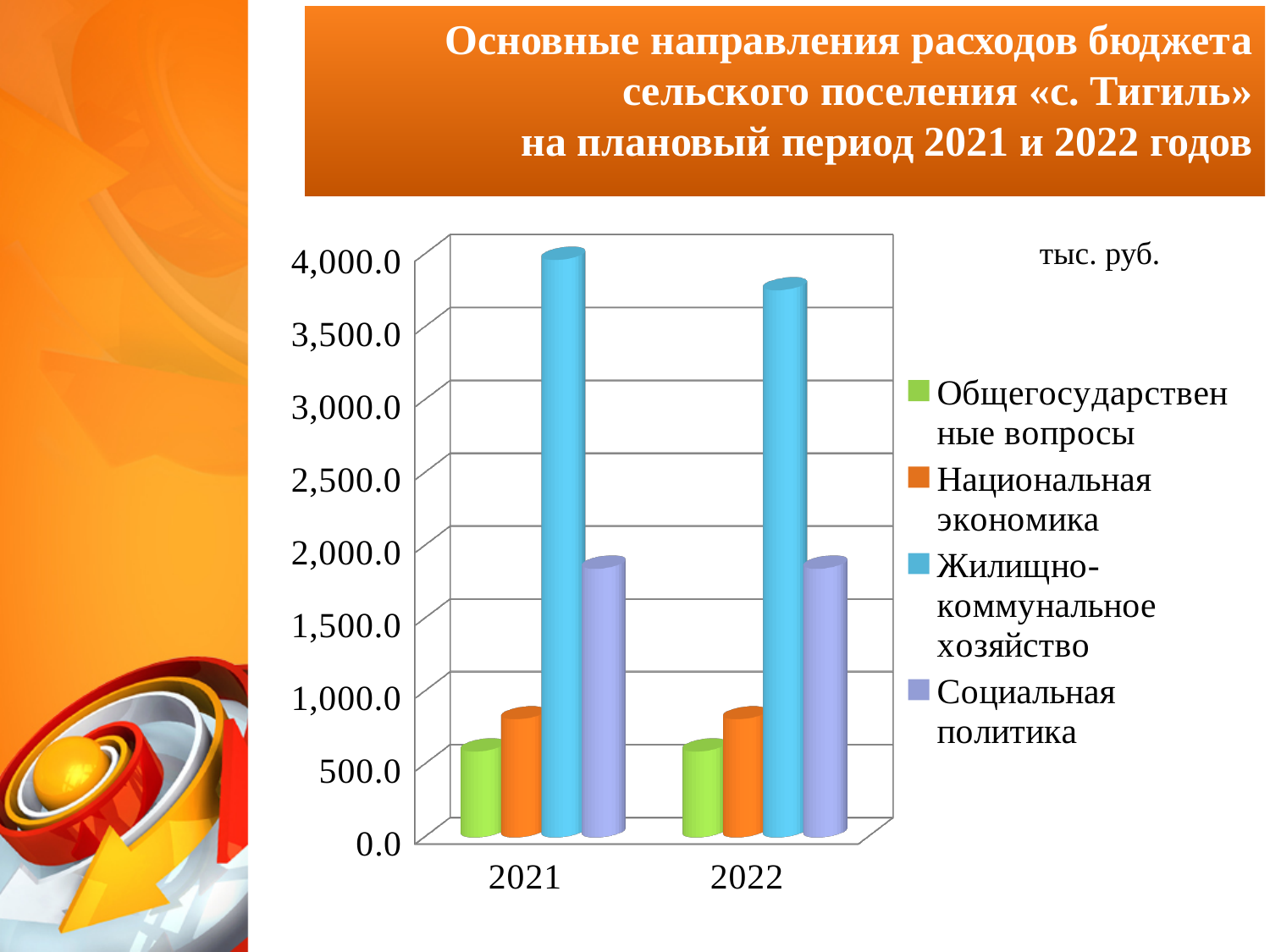
Is the value for Национальная экономика in 2022 greater or less than 1,000.0? less Does the value for Жилищно-коммунальное хозяйство rise or fall from 2021 to 2022? fall How many years (categories) are shown on the x axis of the chart? 2 In 2022, which is larger: Социальная политика or Национальная экономика? Социальная политика What kind of chart is shown on the slide? bar chart Is the value for Социальная политика in 2021 greater or less than 2,000.0? less How many series does the chart legend list? 4 Which expenditure direction has the highest value in 2021? Жилищно-коммунальное хозяйство What unit of measurement is indicated on the chart? тыс. руб. Which expenditure direction has the lowest value in 2022? Общегосударственные вопросы Which colour represents Социальная политика in the chart legend? purple Is the value for Жилищно-коммунальное хозяйство in 2021 greater or less than 3,500.0? greater